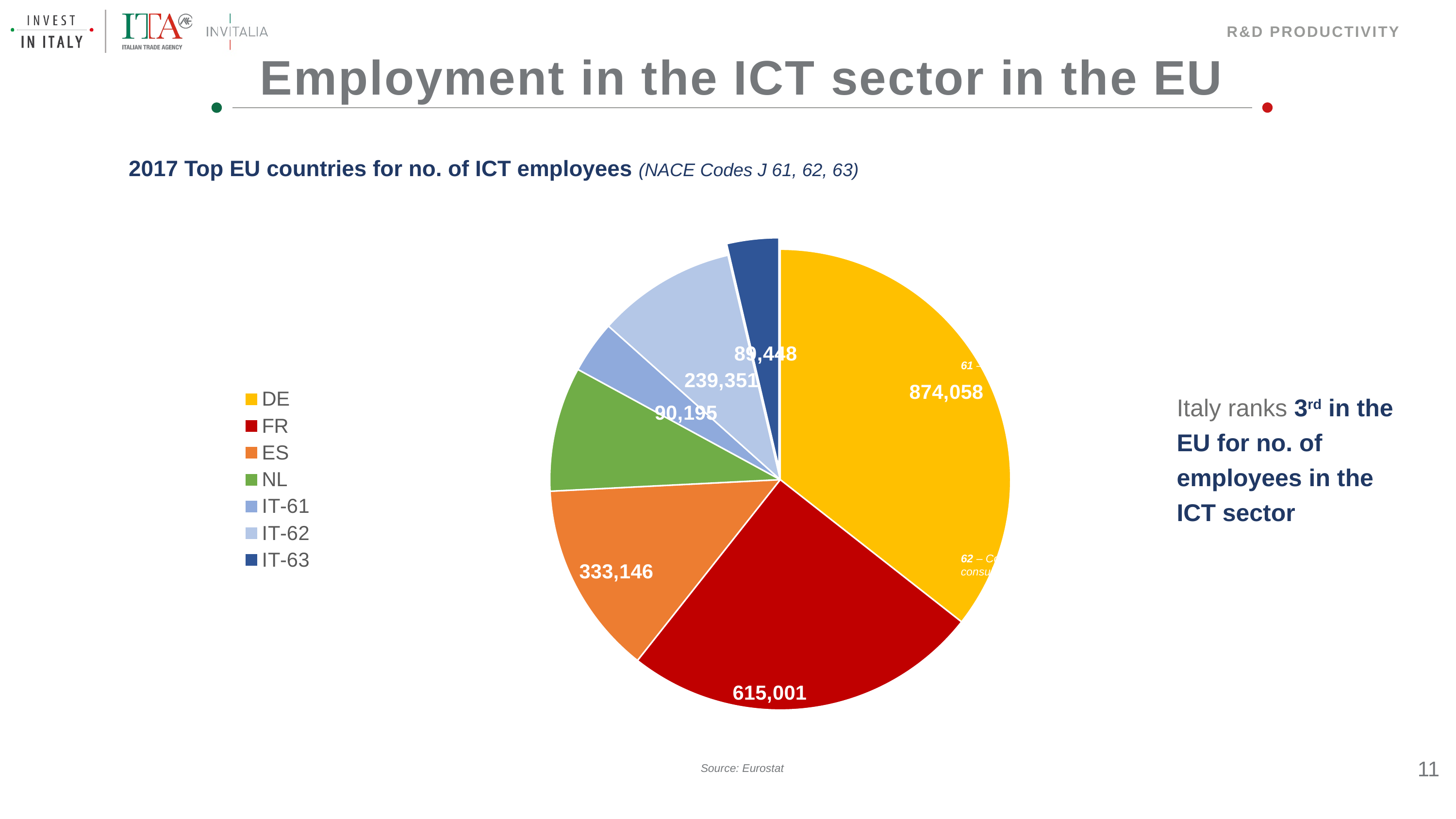
Which is larger, the value for ES or the value for IT-62? ES What value is shown for the IT-63 slice? 89,448 How many entries does the legend list? 7 What value is shown for the IT-62 slice? 239,351 What is the number of ICT employees shown for DE? 874,058 What is the source cited for the chart? Eurostat What type of chart is shown on the slide? Pie chart What is the number of ICT employees shown for FR? 615,001 What is the number of ICT employees shown for ES? 333,146 What is the difference between the values for DE and FR? 259,057 What is the difference between the values for FR and ES? 281,855 Which country has the largest slice of the pie? DE